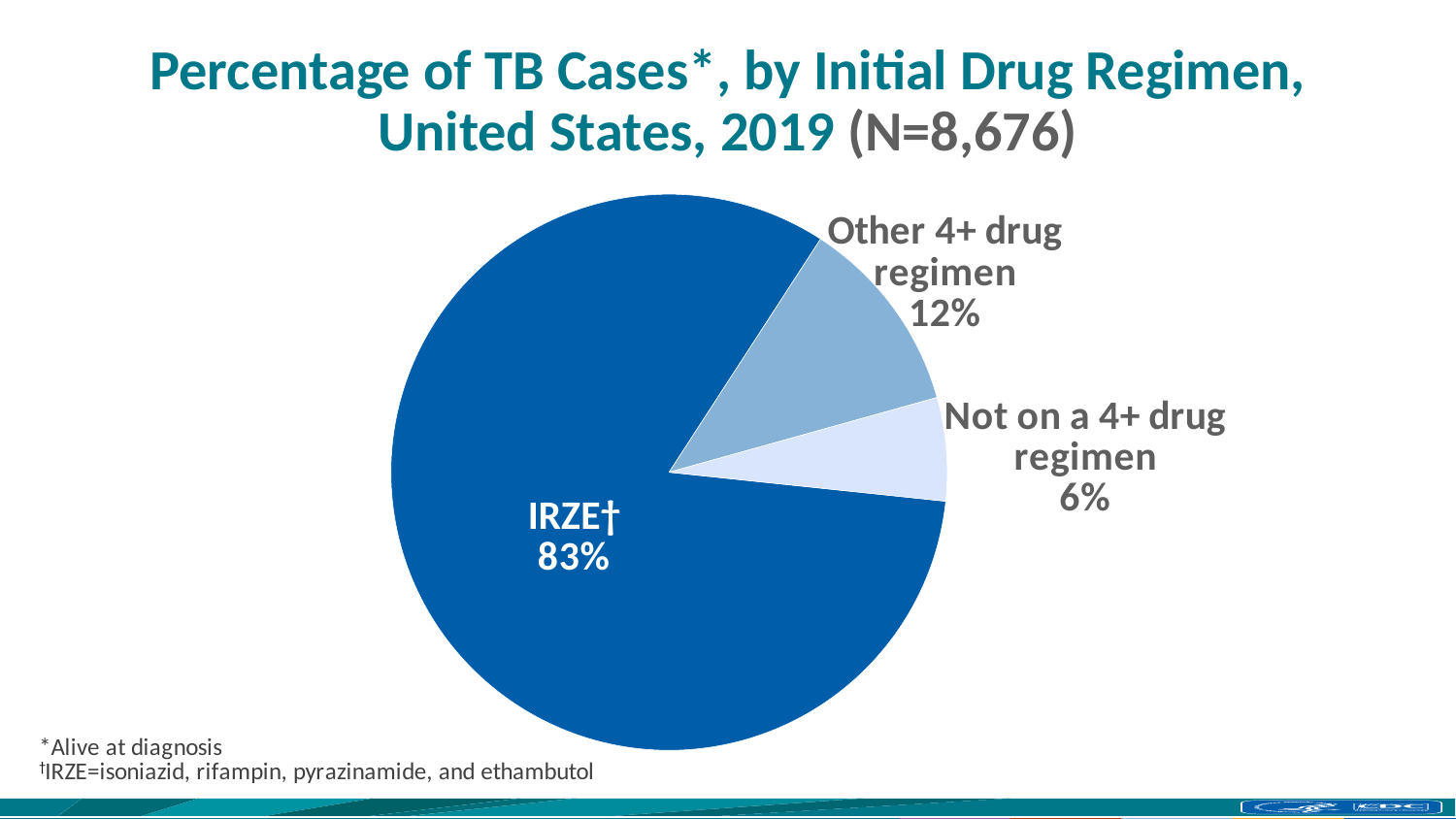
How many slices does the pie chart have? 3 What is the difference in percentage points between the IRZE share and the Other 4+ drug regimen share? 71 What percentage of TB cases were on the IRZE regimen? 83% Which initial drug regimen category has the largest share of TB cases? IRZE What percentage of TB cases were on an Other 4+ drug regimen? 12% What is the total number of TB cases (N) given in the chart title? 8,676 What kind of chart is shown on the slide? pie chart According to the footnote, what does IRZE stand for? isoniazid, rifampin, pyrazinamide, and ethambutol What is the difference in percentage points between the Other 4+ drug regimen share and the Not on a 4+ drug regimen share? 6 What percentage of TB cases were Not on a 4+ drug regimen? 6% Which is larger: the share for Other 4+ drug regimen or the share for Not on a 4+ drug regimen? Other 4+ drug regimen Which initial drug regimen category has the smallest share of TB cases? Not on a 4+ drug regimen